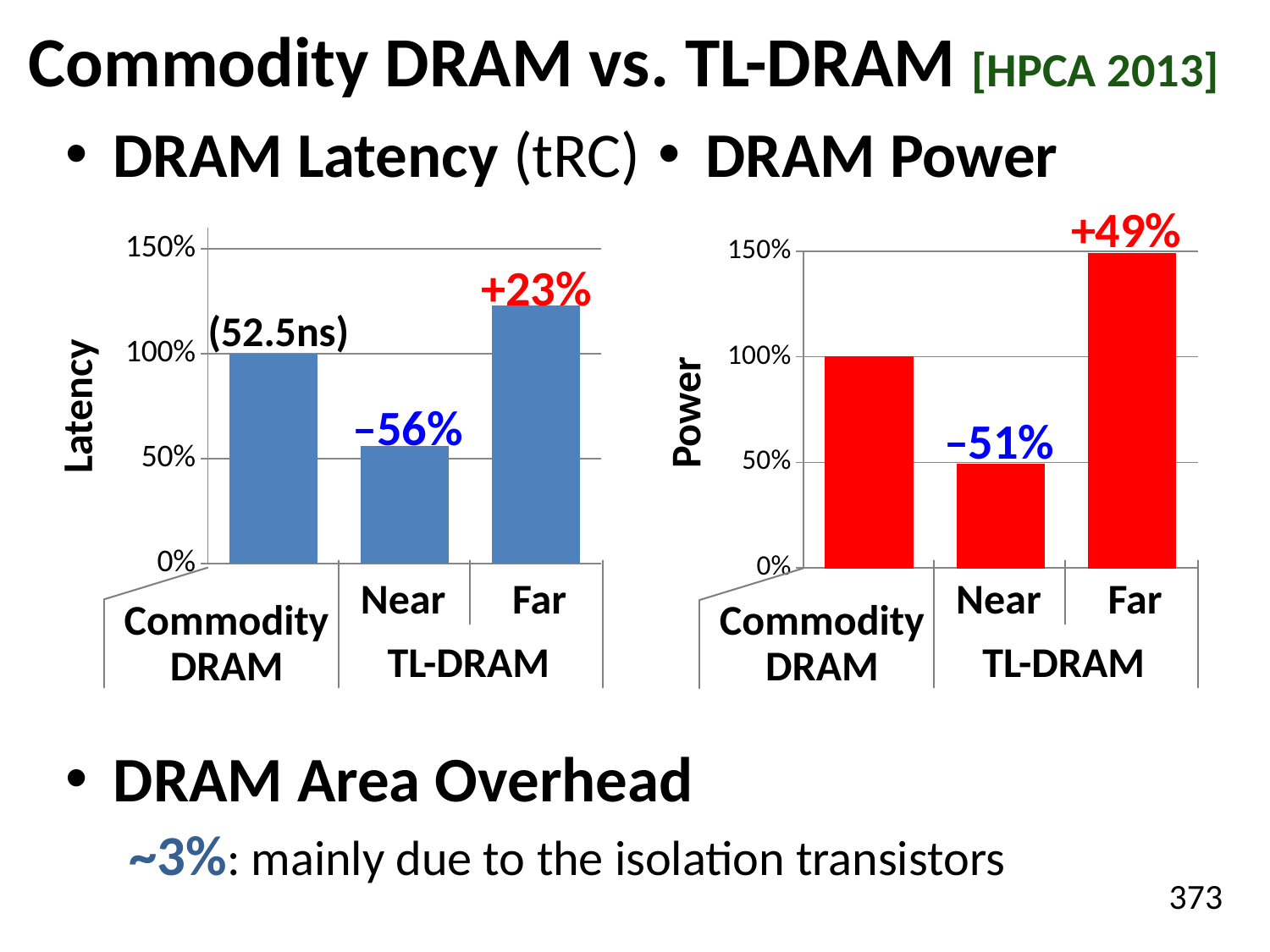
In the DRAM Latency chart, what absolute latency is printed above the Commodity DRAM bar? 52.5ns In the DRAM Power chart, is the value for the Near bar greater or less than 100%? less In the DRAM Power chart, what change is labelled above the Far bar of TL-DRAM? +49% In the DRAM Latency chart, what change is labelled above the Far bar of TL-DRAM? +23% What kind of chart is the DRAM Latency chart on the left? bar chart How many bars are plotted in the DRAM Power chart? 3 In the DRAM Power chart, which bar is the highest? Far In the DRAM Latency chart, is the value for the Far bar greater or less than 100%? greater In the DRAM Power chart, what change is labelled above the Near bar of TL-DRAM? –51% In the DRAM Latency chart, which bar is the lowest? Near In the DRAM Latency chart, what value does the Commodity DRAM bar reach on the axis? 100% In the DRAM Latency chart, what change is labelled above the Near bar of TL-DRAM? –56%